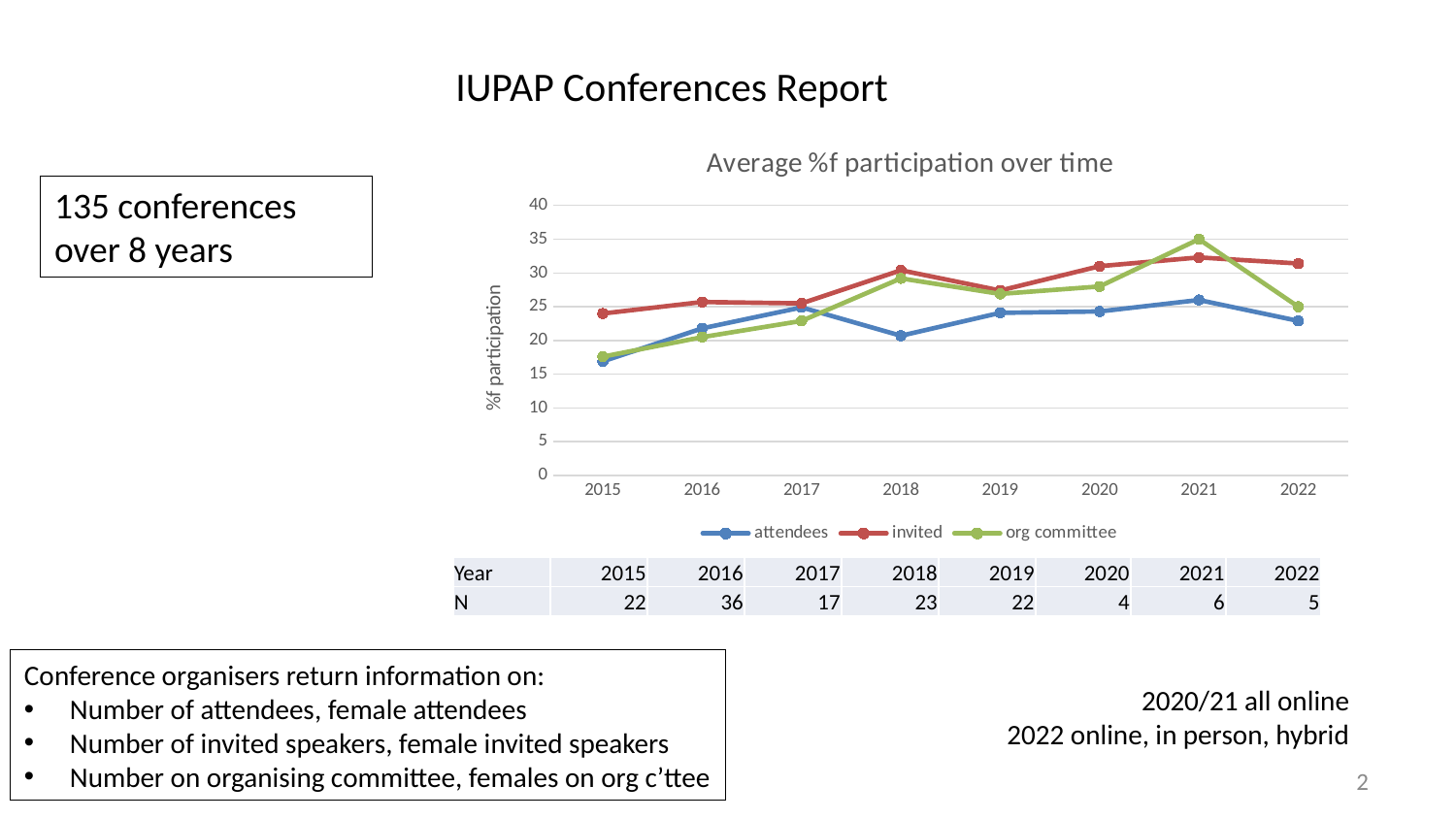
In which year is the invited series at its lowest value? 2015 Does the invited series rise or fall overall from 2015 to 2022? rise In 2021, which series has the higher value, org committee or invited? org committee Is the value for attendees in 2015 greater or less than 20? less What kind of chart is shown on the slide? line chart How many years are plotted along the x axis of the chart? 8 How many series does the chart legend list? 3 In which year does the org committee series reach its highest value? 2021 Is the value for org committee in 2021 greater or less than 30? greater What is the title of the chart? Average %f participation over time In which year is the attendees series at its lowest value? 2015 What is the label on the y axis of the chart? %f participation